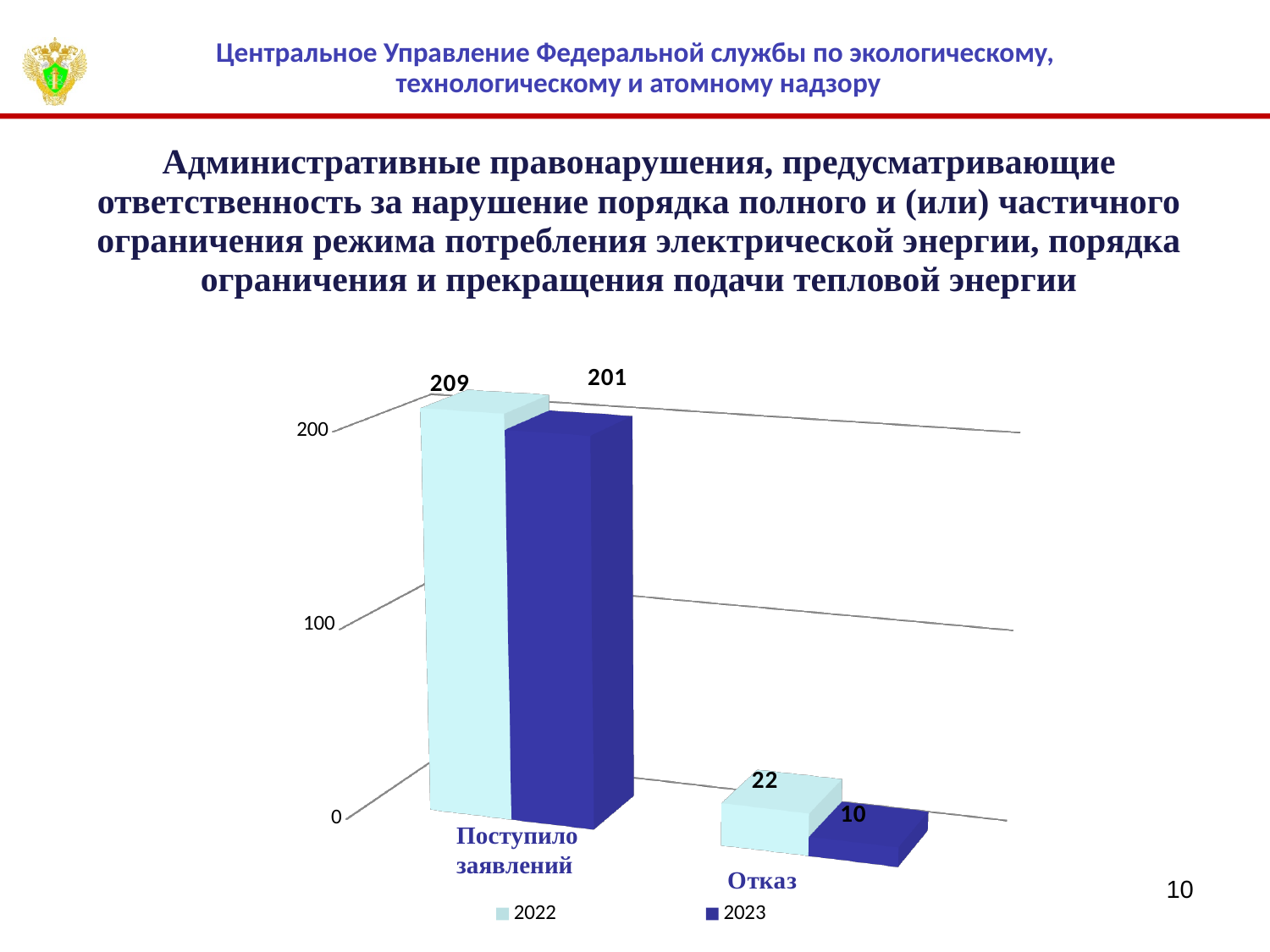
What is the value for 2023 in the "Поступило заявлений" category? 201 What is the value for 2022 in the "Отказ" category? 22 What is the difference between the 2022 and 2023 values for "Отказ"? 12 What is the value for 2023 in the "Отказ" category? 10 What is the difference between the 2022 and 2023 values for "Поступило заявлений"? 8 Which category has the lowest value for the 2023 series? Отказ How many categories are shown on the x axis of the chart? 2 How many series does the legend list? 2 What kind of chart is shown on the slide? Bar chart What is the value for 2022 in the "Поступило заявлений" category? 209 Which is larger for "Отказ": the 2022 value or the 2023 value? 2022 Which category has the highest value for the 2022 series? Поступило заявлений